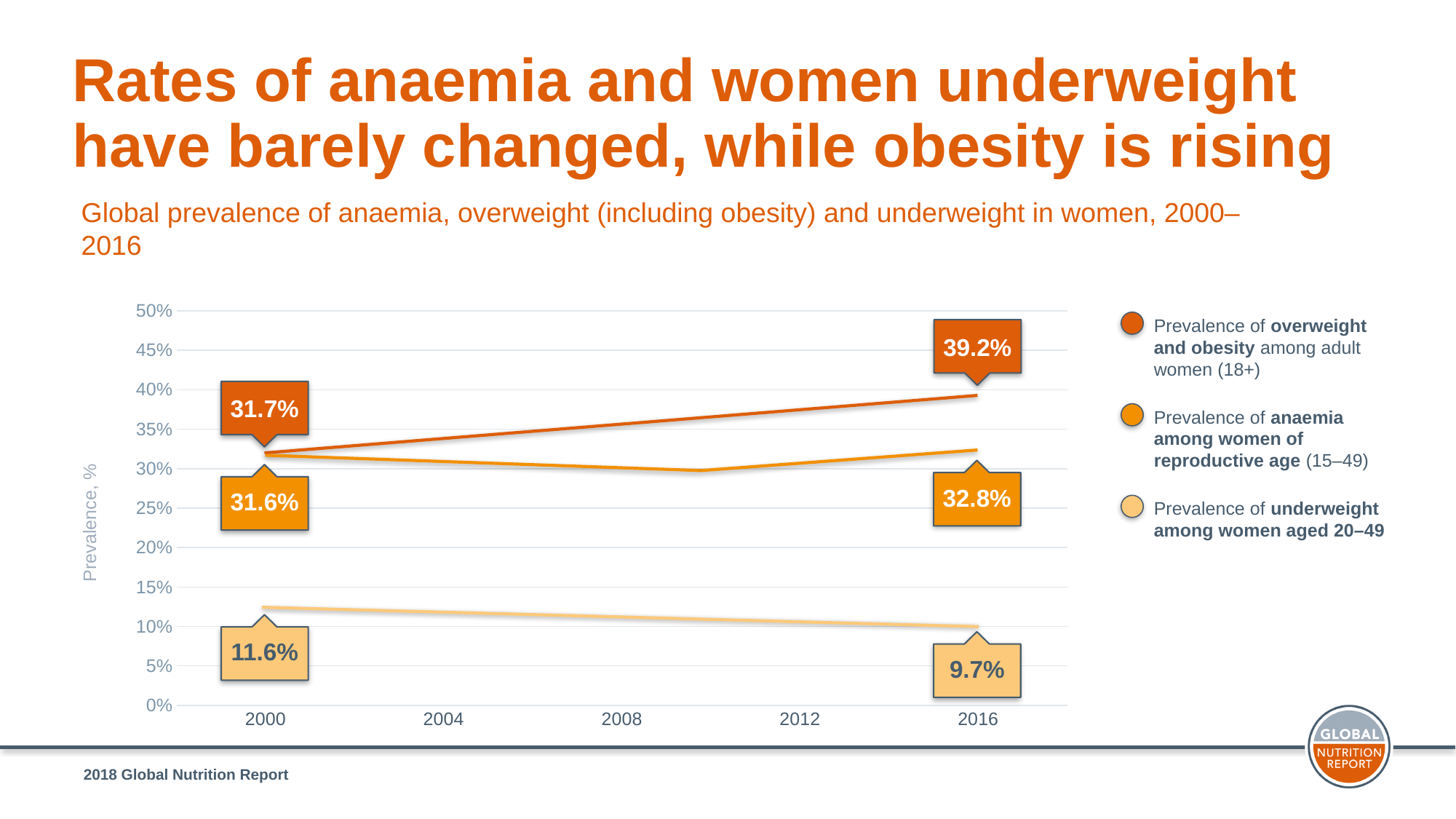
Is the prevalence of anaemia in 2008 greater or less than 35%? less How many series does the legend list? 3 By how many percentage points did the prevalence of underweight fall between 2000 and 2016? 1.9 percentage points Does the prevalence of overweight and obesity rise or fall from 2000 to 2016? Rise What was the prevalence of underweight among women aged 20–49 in 2016? 9.7% What was the prevalence of anaemia among women of reproductive age in 2000? 31.6% What was the prevalence of overweight and obesity among adult women in 2000? 31.7% Which series had the highest value in 2016? Prevalence of overweight and obesity among adult women (18+) By how many percentage points did the prevalence of overweight and obesity change between 2000 and 2016? 7.5 percentage points What kind of chart is shown on the slide? Line chart Which series had the lowest value in 2016? Prevalence of underweight among women aged 20–49 What was the prevalence of overweight and obesity among adult women in 2016? 39.2%